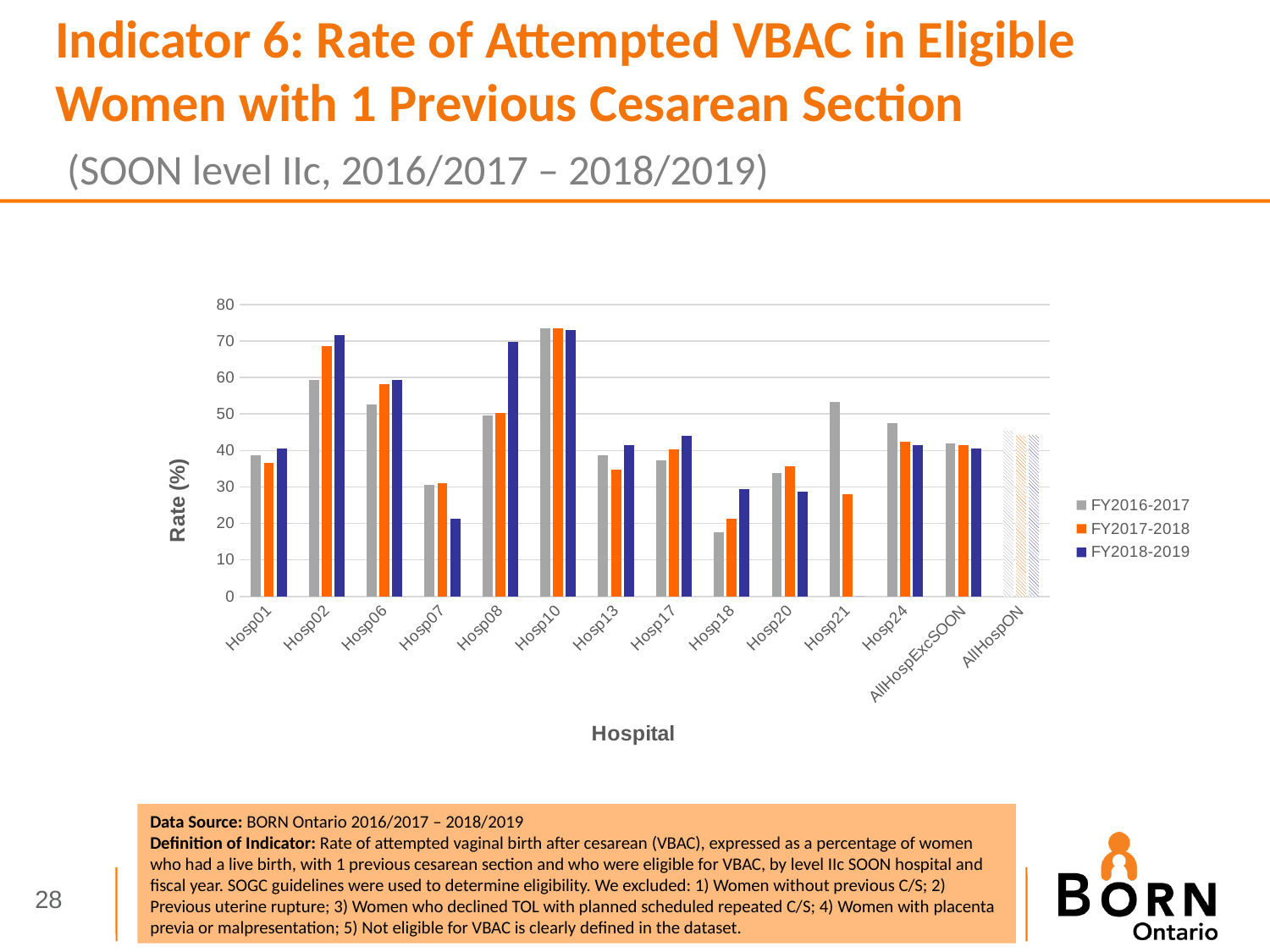
Which hospital has the highest rate in FY2018-2019? Hosp10 What kind of chart is shown on the slide? bar chart How many series does the legend list? 3 For Hosp07, which is larger: the FY2017-2018 value or the FY2018-2019 value? FY2017-2018 Do the values for Hosp18 rise or fall from FY2016-2017 to FY2018-2019? rise Is the FY2018-2019 value for Hosp20 greater or less than 30? less What is the title of the vertical axis? Rate (%) Which hospital has the lowest rate in FY2016-2017? Hosp18 Is the FY2016-2017 value for Hosp18 greater or less than 20? less Is the FY2016-2017 value for Hosp21 greater or less than 50? greater How many hospital categories are shown on the x axis? 14 Which is larger for FY2016-2017: the value for Hosp01 or the value for Hosp02? Hosp02